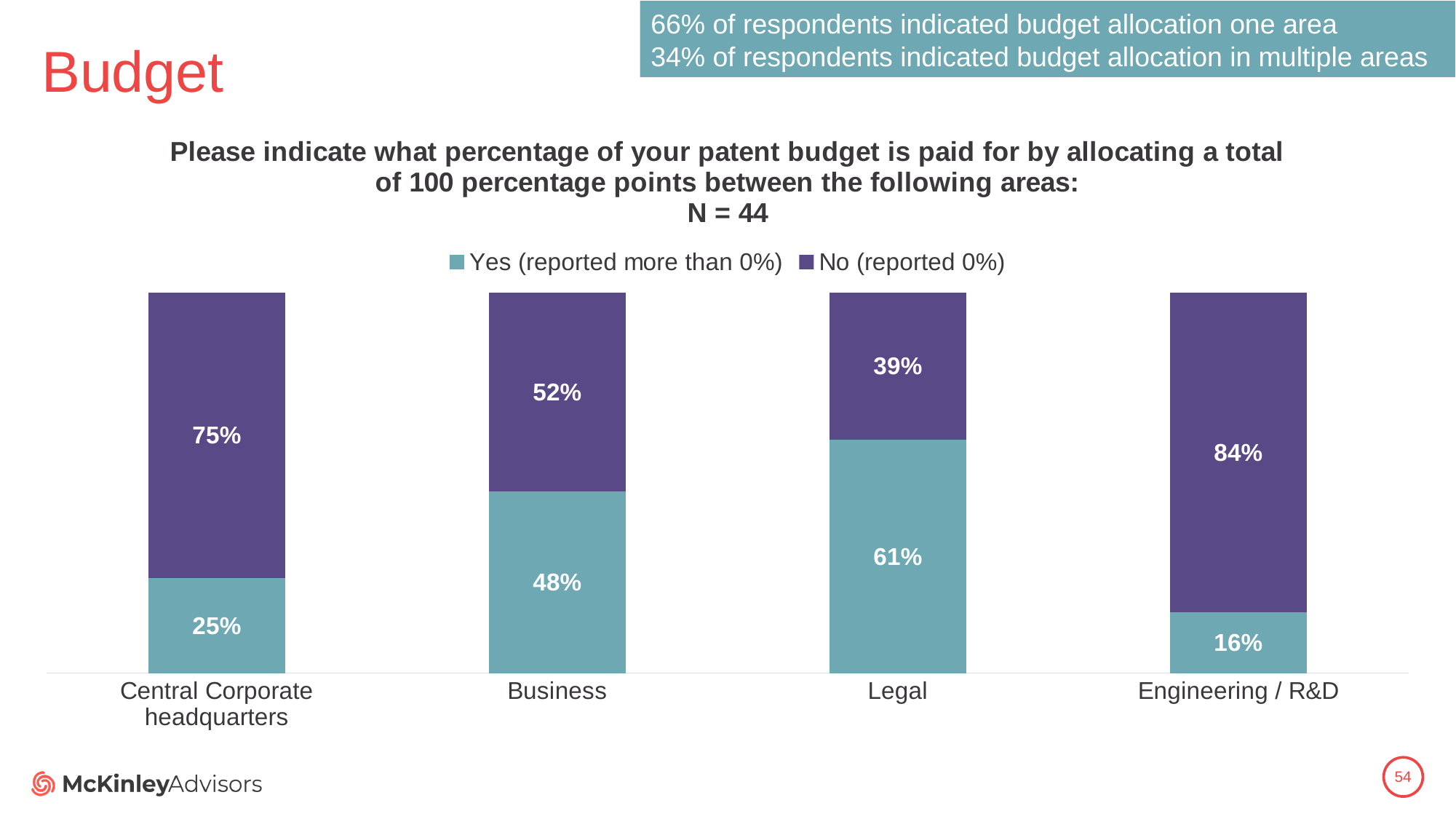
What kind of chart is shown on the slide? Stacked bar chart How many series does the legend list? 2 What is the 'No (reported 0%)' value for Business? 52% What is the 'Yes (reported more than 0%)' value for Central Corporate headquarters? 25% Which category has the lowest 'Yes (reported more than 0%)' value? Engineering / R&D What is the 'No (reported 0%)' value for Engineering / R&D? 84% Which category has the highest 'Yes (reported more than 0%)' value? Legal What is the 'Yes (reported more than 0%)' value for Legal? 61% What is the difference between the 'No (reported 0%)' values for Engineering / R&D and Legal? 45% How many categories are shown on the x axis? 4 What is the total of the stacked bar for Business? 100% Which is larger: the 'Yes (reported more than 0%)' value for Business or for Central Corporate headquarters? Business